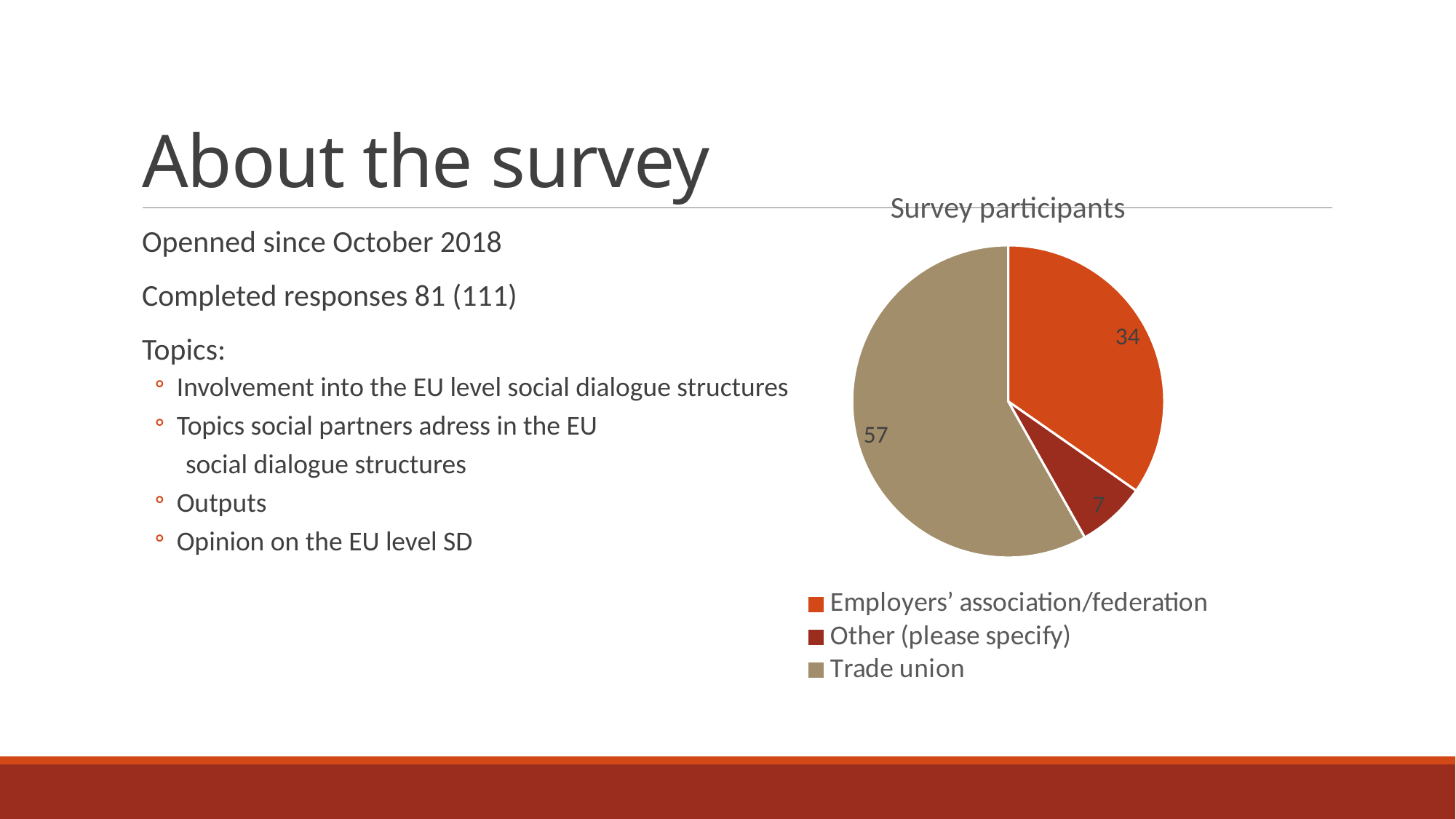
Which is larger, Employers' association/federation or Other (please specify)? Employers' association/federation How many entries does the legend list? 3 What is the value for Employers' association/federation? 34 What is the title of the chart? Survey participants What is the total of all slices in the pie chart? 98 Which category has the smallest slice? Other (please specify) What is the value for Trade union? 57 What is the value for Other (please specify)? 7 How many categories does the pie chart show? 3 What type of chart is shown on the slide? pie chart Which category has the largest slice? Trade union What is the difference between the Trade union value and the Employers' association/federation value? 23